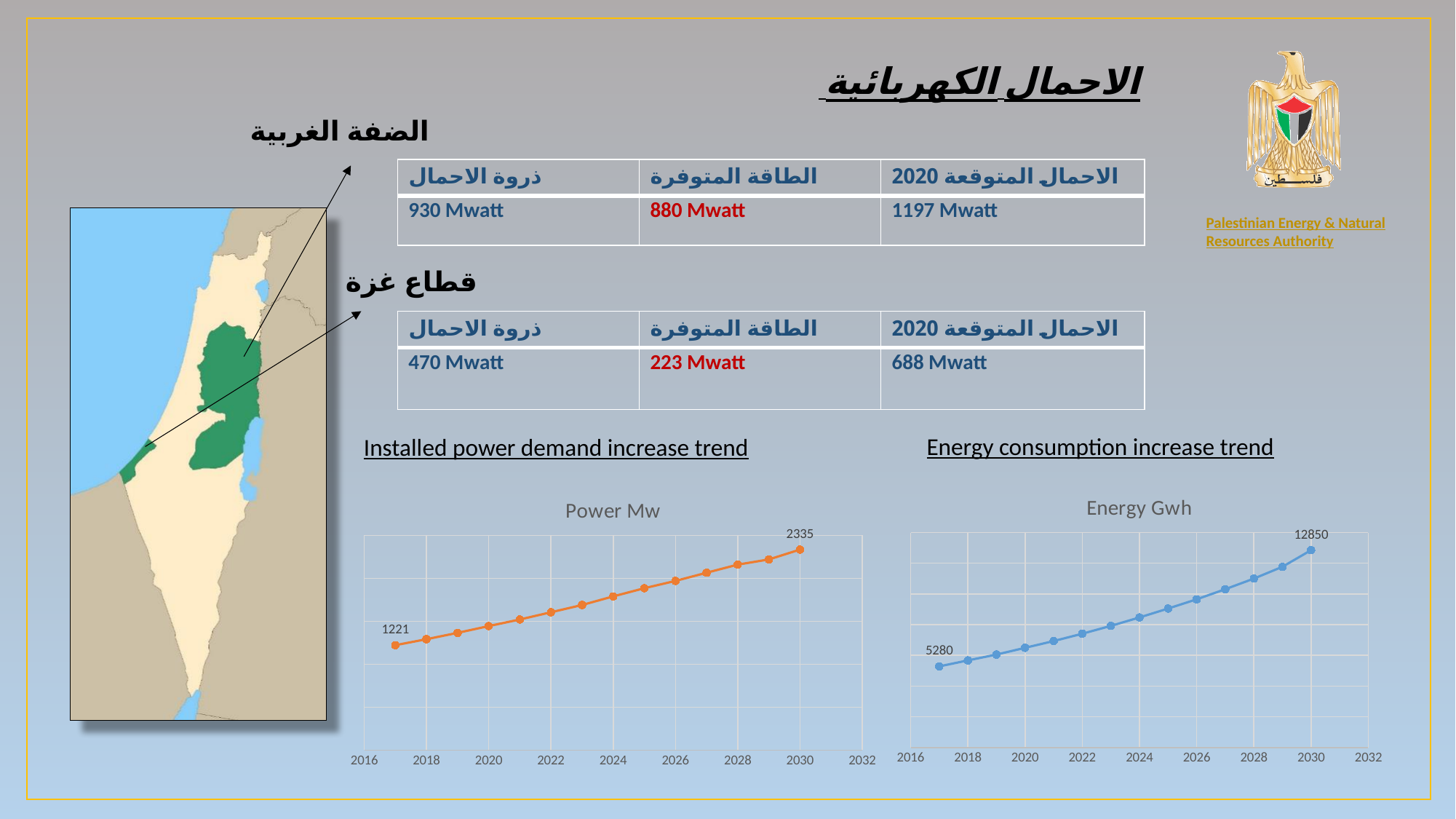
In the "Power Mw" chart, what is the value labelled at the first point (2017)? 1221 In the "Energy Gwh" chart, do the values rise or fall along the x axis? rise What is the heading above the "Energy Gwh" chart? Energy consumption increase trend In the "Power Mw" chart, what is the value labelled at the 2030 point? 2335 In the "Power Mw" chart, do the values rise or fall from 2017 to 2030? rise In the "Energy Gwh" chart, what is the value labelled at the first point (2017)? 5280 What kind of chart is the "Power Mw" chart? line chart In the "Energy Gwh" chart, what is the value labelled at the 2030 point? 12850 In the "Energy Gwh" chart, which year has the highest value? 2030 In the "Energy Gwh" chart, what is the difference between the 2030 value and the 2017 value? 7570 In the "Power Mw" chart, which year has the lowest value? 2017 In the "Power Mw" chart, what is the difference between the 2030 value and the 2017 value? 1114